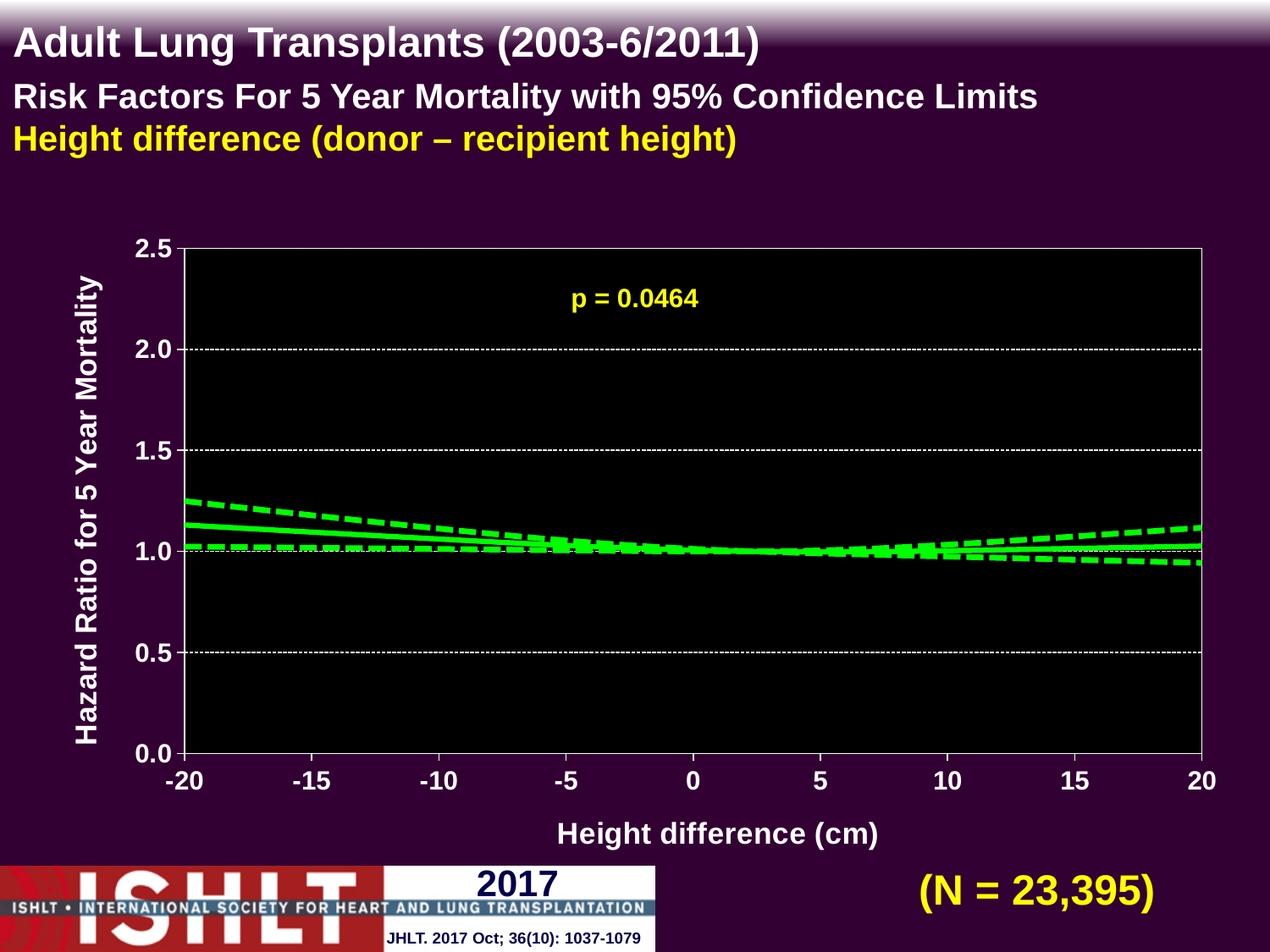
Is the upper confidence limit at a height difference of 20 cm greater or less than 1.5? less What sample size (N) is shown on the slide? 23,395 Does the solid hazard ratio line rise or fall as the height difference goes from -20 cm to 0 cm? fall Is the hazard ratio of the solid line at a height difference of -20 cm greater or less than 1.5? less Is the hazard ratio of the solid line at a height difference of -20 cm greater or less than 1.0? greater What kind of chart is shown on the slide? line chart What p-value is printed on the chart? p = 0.0464 How many lines (solid and dashed) are plotted on the chart? 3